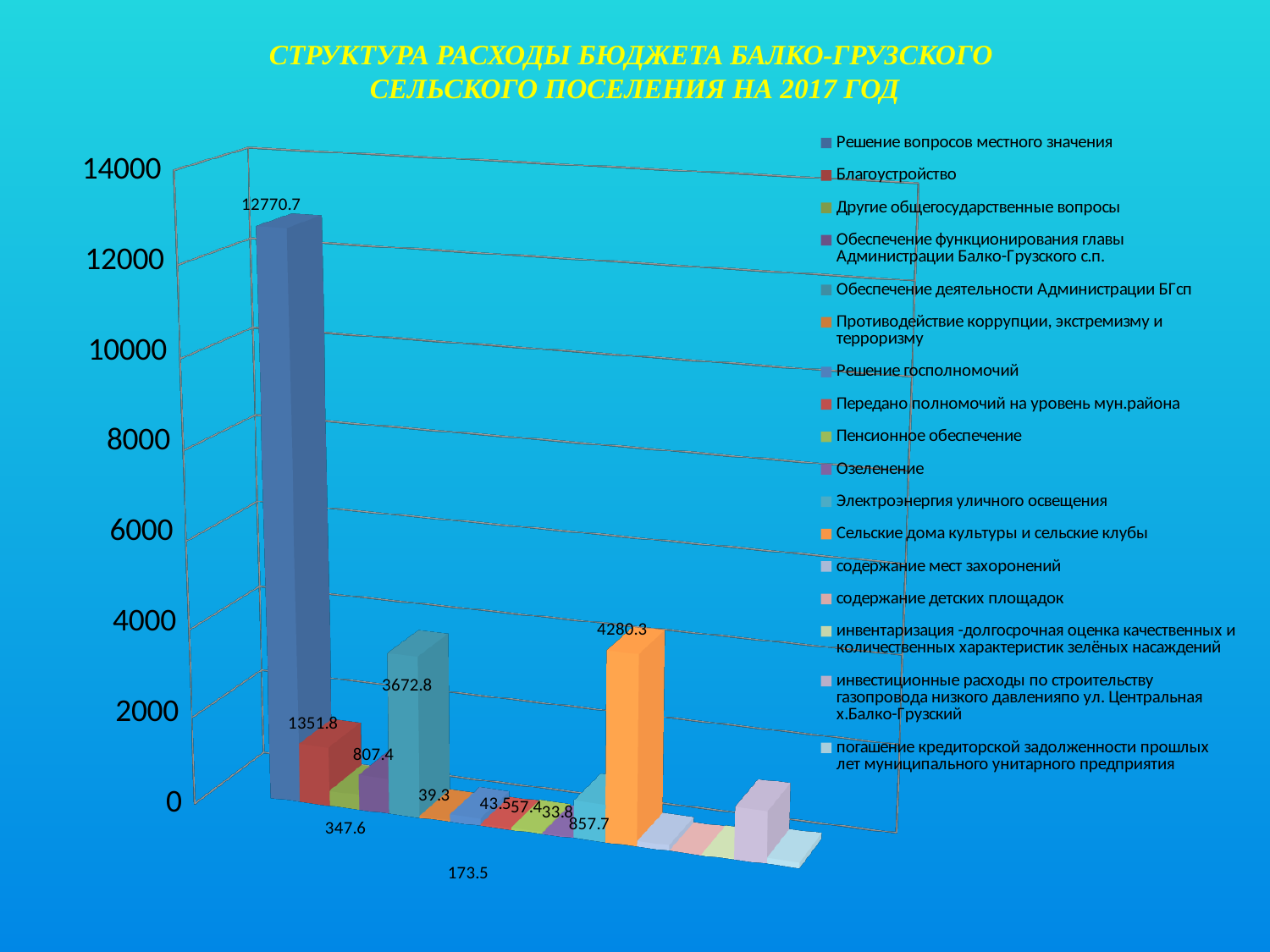
Which is larger: Благоустройство or Сельские дома культуры и сельские клубы? Сельские дома культуры и сельские клубы What kind of chart is shown on the slide? bar chart Is the value for Решение вопросов местного значения greater or less than 12000? greater What is the value for Сельские дома культуры и сельские клубы? 4280.3 What is the value for Обеспечение деятельности Администрации БГсп? 3672.8 What is the value for Благоустройство? 1351.8 What is the difference between Решение вопросов местного значения and Сельские дома культуры и сельские клубы? 8490.4 What is the difference between Сельские дома культуры и сельские клубы and Обеспечение деятельности Администрации БГсп? 607.5 What is the value for Решение вопросов местного значения? 12770.7 How many series does the legend list? 17 Which series has the highest value in the chart? Решение вопросов местного значения What is the title of the chart on the slide? СТРУКТУРА РАСХОДЫ БЮДЖЕТА БАЛКО-ГРУЗСКОГО СЕЛЬСКОГО ПОСЕЛЕНИЯ НА 2017 ГОД